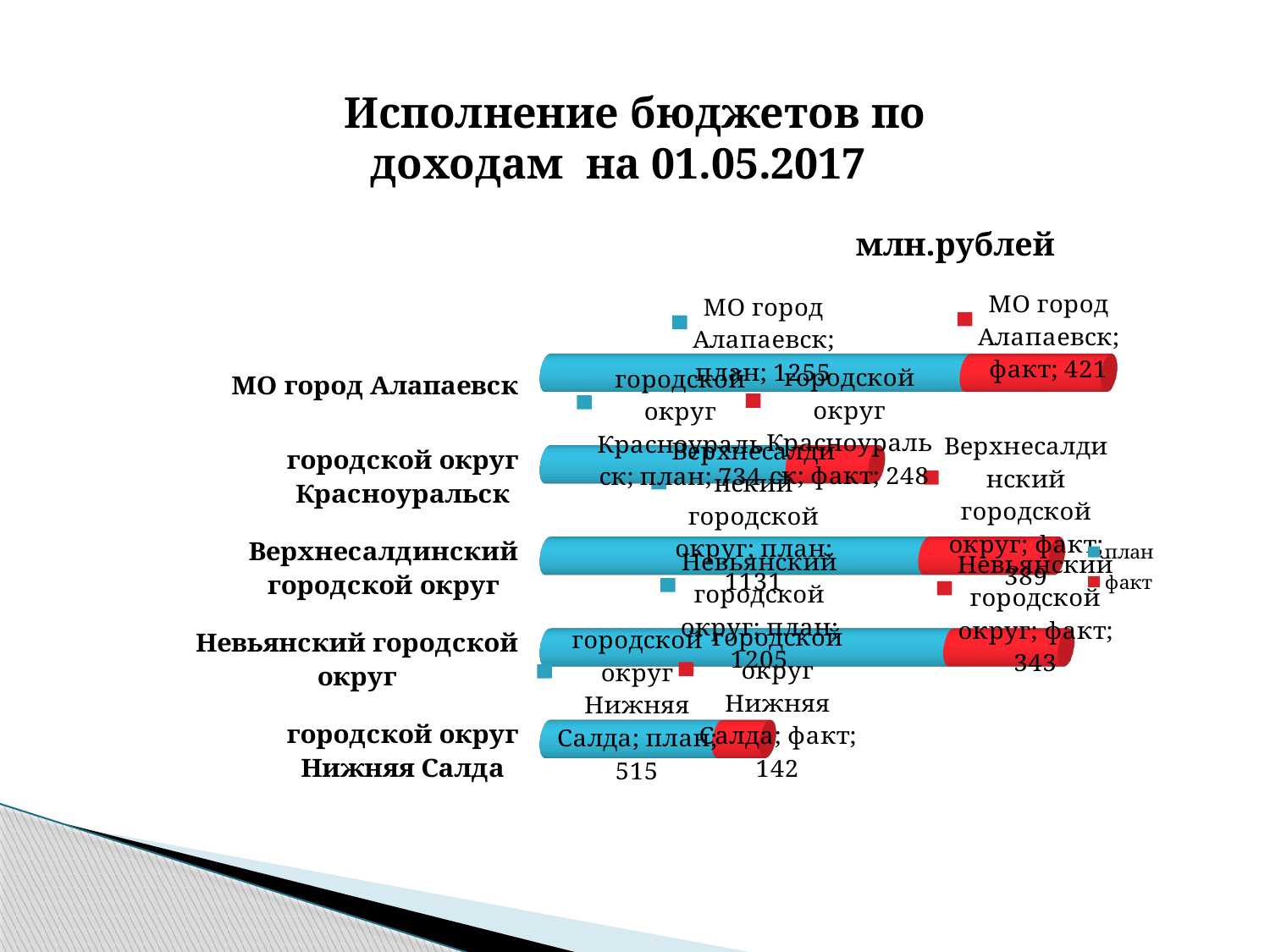
How many series does the legend list? 2 What is the difference between the план and факт values for МО город Алапаевск? 834 What is the факт value for Невьянский городской округ? 343 What is the план value for МО город Алапаевск? 1255 Which category has the highest план value? МО город Алапаевск What is the план value for Верхнесалдинский городской округ? 1131 Which is larger: the факт value for Верхнесалдинский городской округ or the факт value for Невьянский городской округ? Верхнесалдинский городской округ How many categories are shown in the chart? 5 What type of chart is shown on the slide? bar chart What is the план value for городской округ Нижняя Салда? 515 What is the факт value for городской округ Красноуральск? 248 Which category has the lowest факт value? городской округ Нижняя Салда